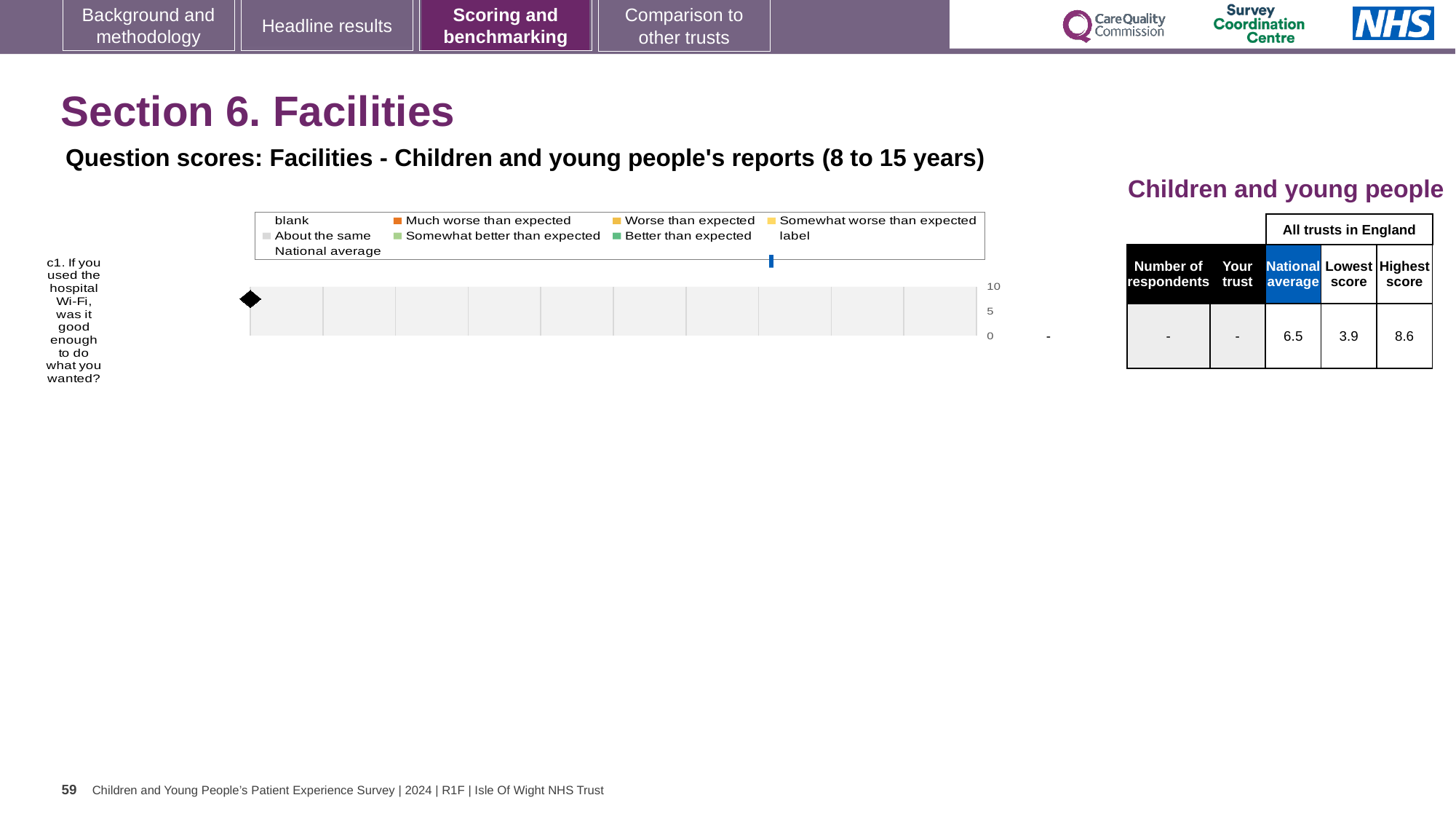
In the table, what is the National average score for question c1? 6.5 How many questions (categories) are plotted on the chart? 1 Which is larger in the table for question c1, the National average or the Lowest score? National average What is the label of the single category plotted on the chart? c1. If you used the hospital Wi-Fi, was it good enough to do what you wanted? What value is shown for 'Your trust' in the table for question c1? - Which colour does the legend use for 'Much worse than expected'? orange In the table, what is the Highest score across all trusts in England for question c1? 8.6 What kind of chart is shown on the slide? bar chart What is the highest value shown on the chart's value axis? 10 In the table, what is the Lowest score across all trusts in England for question c1? 3.9 What is the difference between the Highest score and the Lowest score in the table for question c1? 4.7